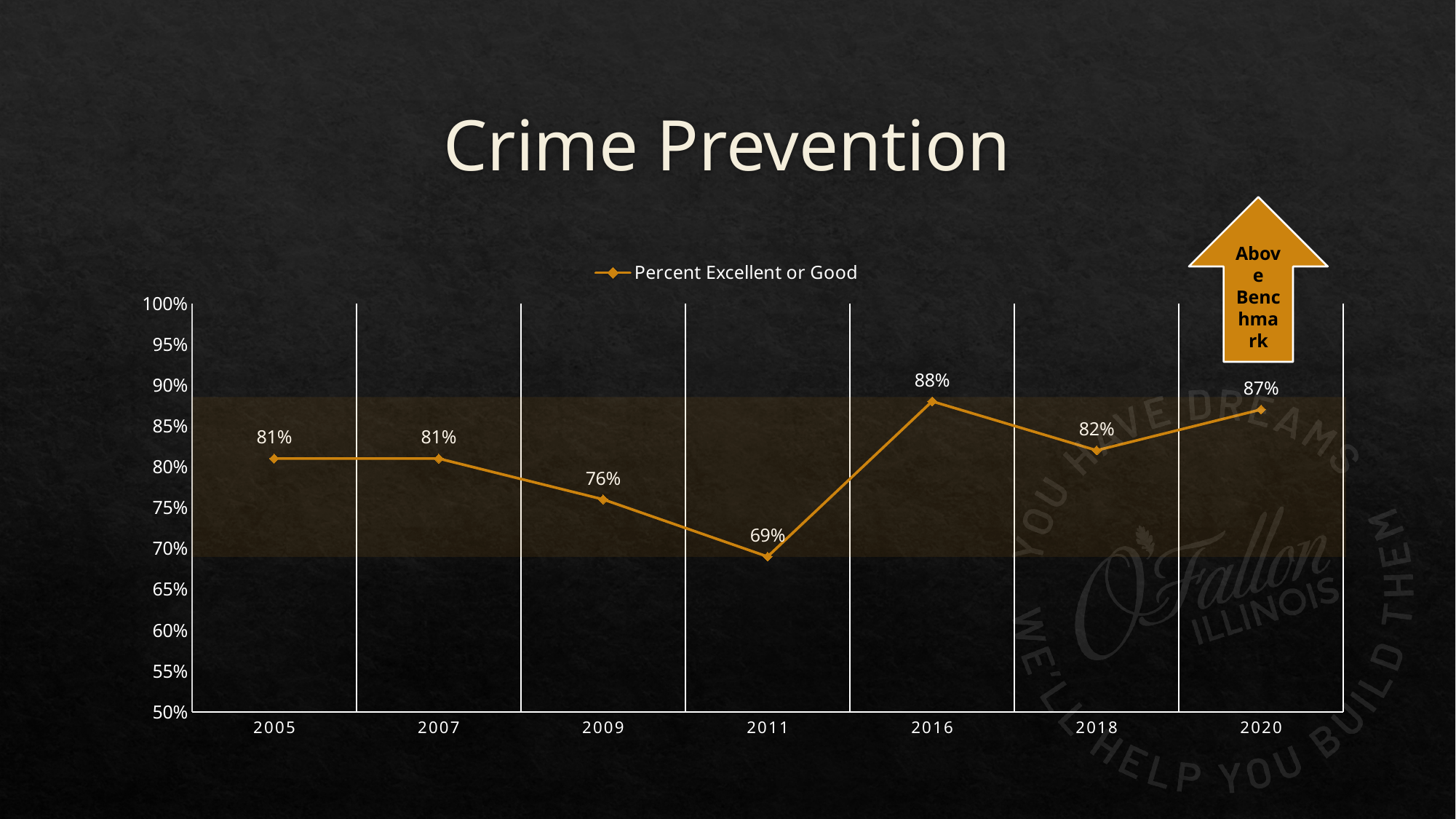
How many years are plotted on the x axis? 7 Is the value for 2016 greater or less than 85%? greater What is the value for 2020? 87% Which is larger, the value for 2018 or the value for 2020? 2020 What is the name of the series in the legend? Percent Excellent or Good What is the value for 2011? 69% What is the difference between the values for 2016 and 2011? 19% Which year has the highest value? 2016 What is the value for 2009? 76% Which year has the lowest value? 2011 How many series does the legend list? 1 What kind of chart is shown? line chart